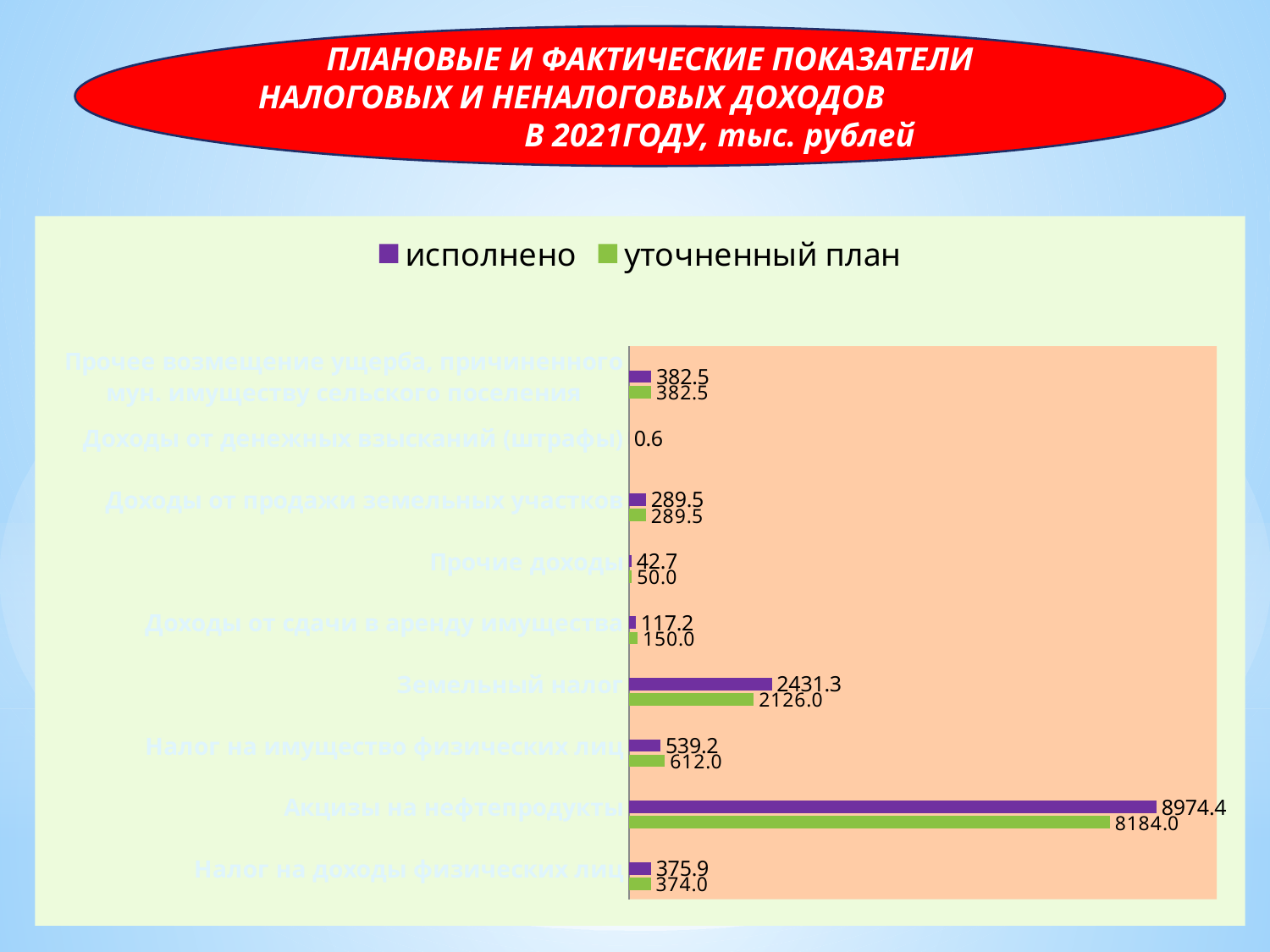
For "Налог на имущество физических лиц", which is larger: "исполнено" or "уточненный план"? уточненный план What is the value of "уточненный план" for "Доходы от сдачи в аренду имущества"? 150.0 What is the value of "исполнено" for "Акцизы на нефтепродукты"? 8974.4 What colour represents the "исполнено" series in the legend? purple What is the difference between "исполнено" and "уточненный план" for "Земельный налог"? 305.3 How many series does the legend list? 2 What kind of chart is shown on the slide? bar chart Which category has the highest "исполнено" value? Акцизы на нефтепродукты What is the difference between "исполнено" and "уточненный план" for "Акцизы на нефтепродукты"? 790.4 What is the value of "уточненный план" for "Земельный налог"? 2126.0 For "Земельный налог", which is larger: "исполнено" or "уточненный план"? исполнено How many categories are plotted on the chart? 9